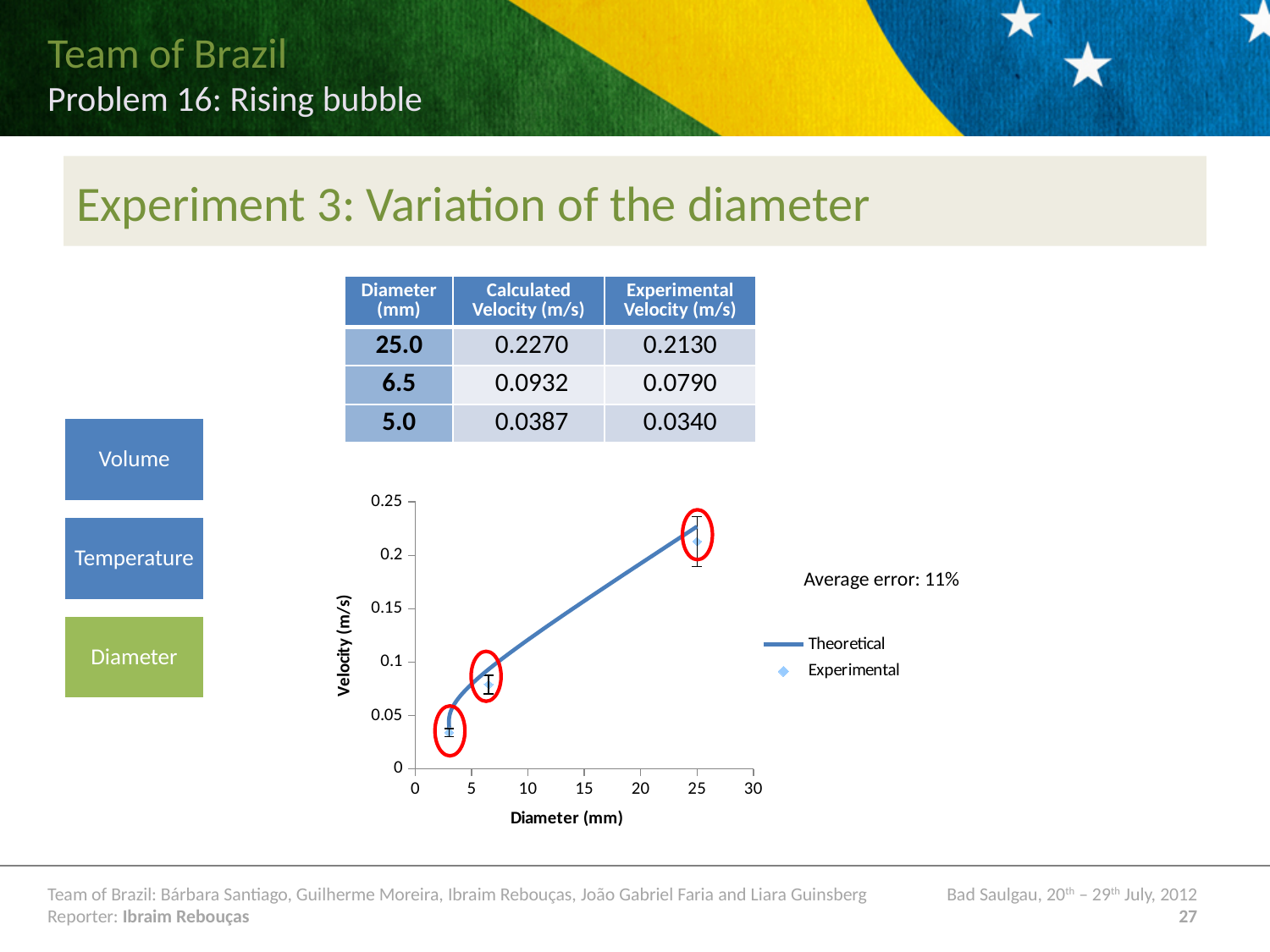
Is the experimental velocity at a diameter of 25 mm greater or less than 0.25 m/s? less Is the experimental velocity at a diameter of 25 mm greater or less than 0.15 m/s? greater What are the axis titles of the chart? Diameter (mm) on the x axis and Velocity (m/s) on the y axis Which experimental point has the lowest velocity? The point with the smallest diameter (leftmost point) Is the theoretical velocity at a diameter of 25 mm greater or less than 0.2 m/s? greater How many series does the chart legend list? 2 What are the two series named in the chart legend? Theoretical and Experimental Does the theoretical velocity rise or fall as the diameter increases along the x axis? rises Which experimental point has the highest velocity? The point at 25 mm diameter How many experimental data points are plotted on the chart? 3